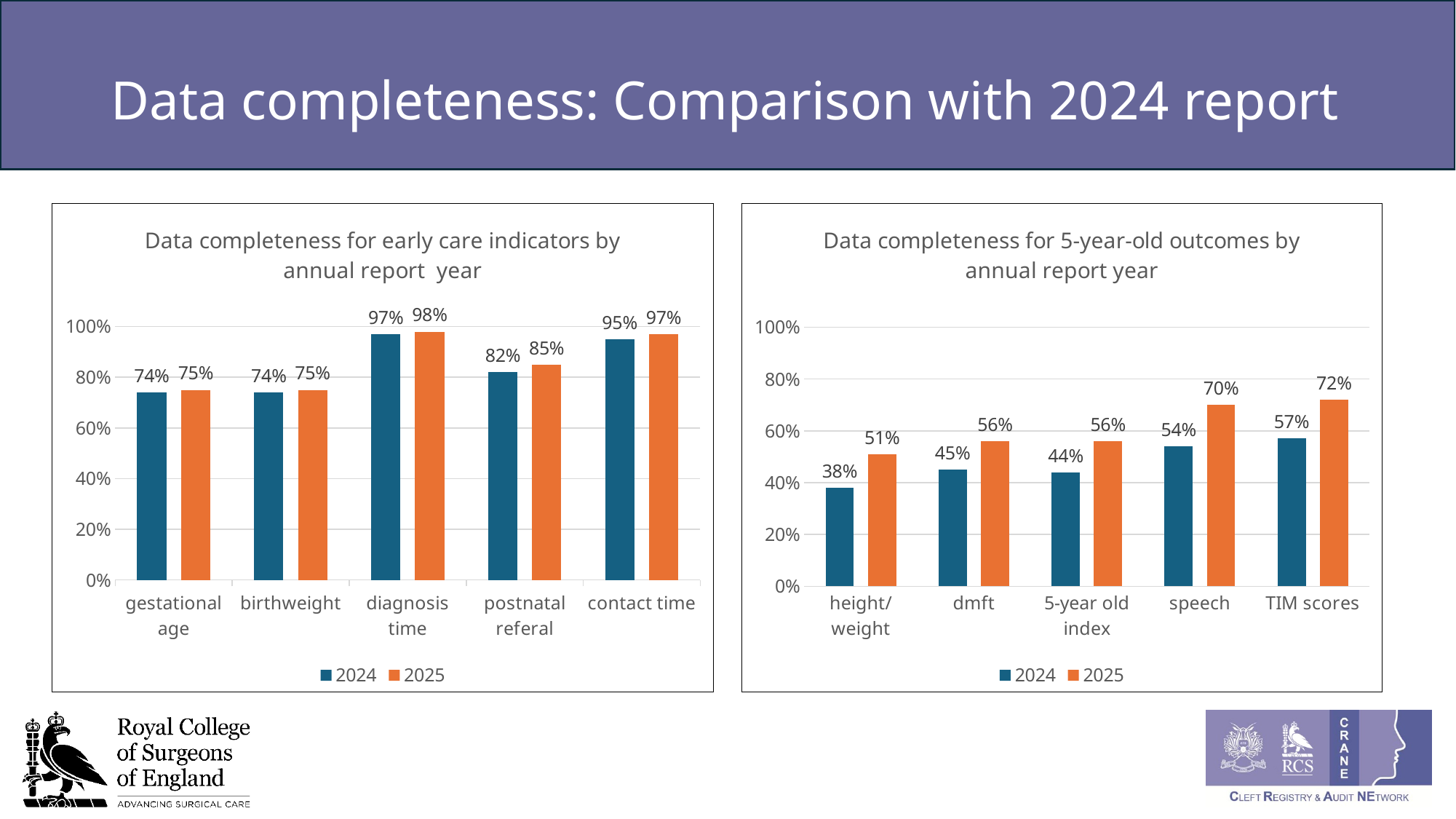
In the 'Data completeness for 5-year-old outcomes by annual report year' chart, which category has the highest 2025 value? TIM scores In the 'Data completeness for early care indicators by annual report year' chart, what is the 2025 value for diagnosis time? 98% What kind of chart is the 'Data completeness for 5-year-old outcomes by annual report year' chart? bar chart In the 'Data completeness for 5-year-old outcomes by annual report year' chart, what is the difference between the 2025 and 2024 values for speech? 16% In the 'Data completeness for 5-year-old outcomes by annual report year' chart, what is the 2024 value for height/weight? 38% In the 'Data completeness for early care indicators by annual report year' chart, which category has the lowest 2024 value? gestational age and birthweight (both 74%) In the 'Data completeness for early care indicators by annual report year' chart, what is the difference between the 2025 and 2024 values for contact time? 2% In the 'Data completeness for 5-year-old outcomes by annual report year' chart, is the 2024 value for dmft larger or smaller than the 2024 value for 5-year old index? larger In the 'Data completeness for 5-year-old outcomes by annual report year' chart, how many series does the legend list? 2 In the 'Data completeness for early care indicators by annual report year' chart, what is the 2024 value for postnatal referal? 82% In the 'Data completeness for early care indicators by annual report year' chart, which colour represents the 2025 series? orange In the 'Data completeness for early care indicators by annual report year' chart, how many categories are shown on the x axis? 5